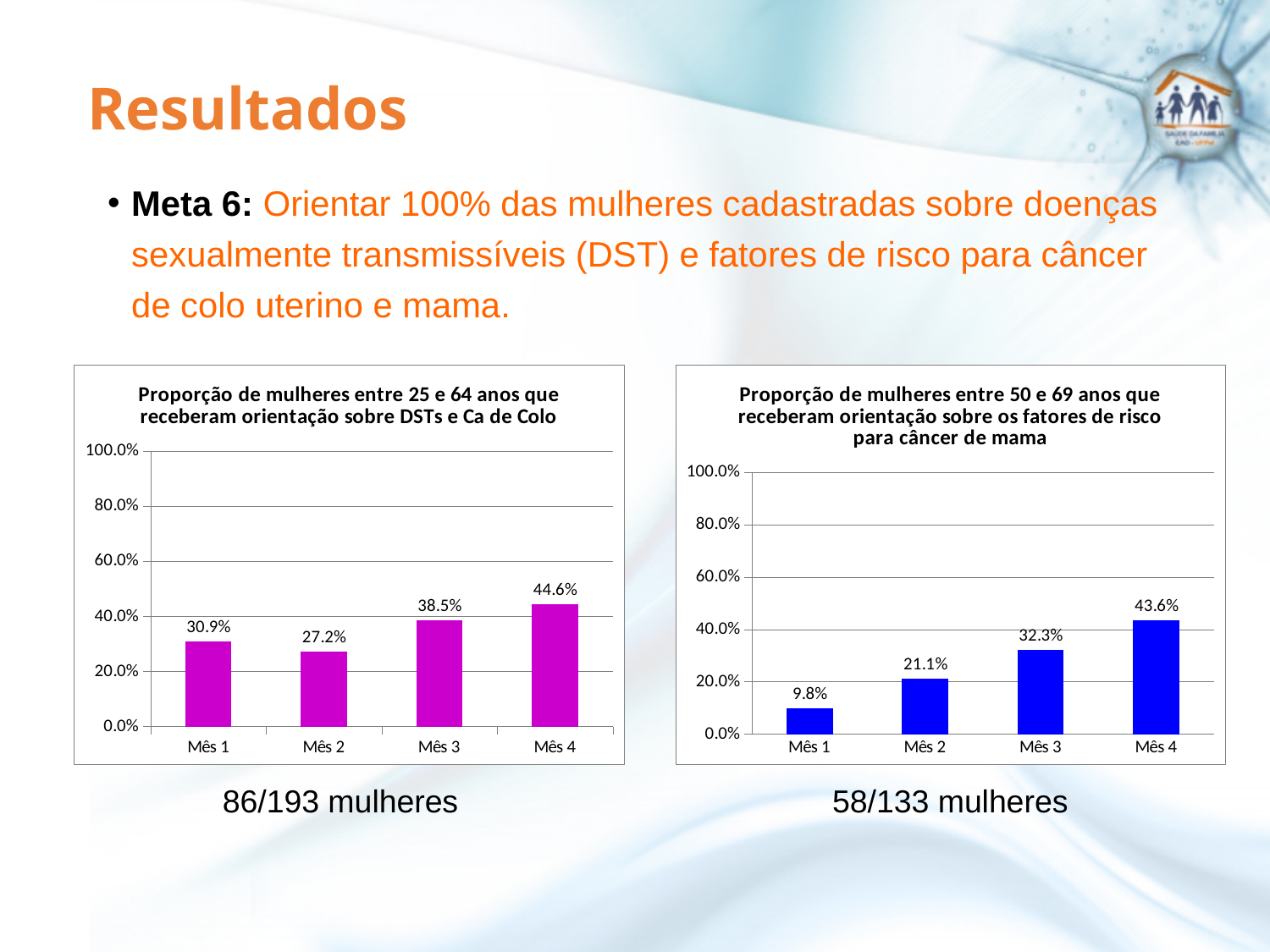
In the left chart (Proporção de mulheres entre 25 e 64 anos), how many months are plotted? 4 What type of chart is the right chart (Proporção de mulheres entre 50 e 69 anos)? Bar chart In the right chart (Proporção de mulheres entre 50 e 69 anos), what is the value for Mês 4? 43.6% In the right chart (Proporção de mulheres entre 50 e 69 anos que receberam orientação sobre os fatores de risco para câncer de mama), what is the value for Mês 2? 21.1% In the left chart (Proporção de mulheres entre 25 e 64 anos), which month has the highest value? Mês 4 Which is larger: the Mês 1 value in the left chart (25 e 64 anos) or the Mês 1 value in the right chart (50 e 69 anos)? The left chart (30.9%) In the left chart (Proporção de mulheres entre 25 e 64 anos que receberam orientação sobre DSTs e Ca de Colo), what is the value for Mês 1? 30.9% In the right chart (Proporção de mulheres entre 50 e 69 anos), what is the difference between the values for Mês 3 and Mês 1? 22.5% In the left chart (Proporção de mulheres entre 25 e 64 anos), which month has the lowest value? Mês 2 In the right chart (Proporção de mulheres entre 50 e 69 anos), which month has the lowest value? Mês 1 In the left chart (Proporção de mulheres entre 25 e 64 anos), what is the difference between the values for Mês 4 and Mês 3? 6.1% In the right chart (Proporção de mulheres entre 50 e 69 anos), do the values rise or fall from Mês 1 to Mês 4? rise